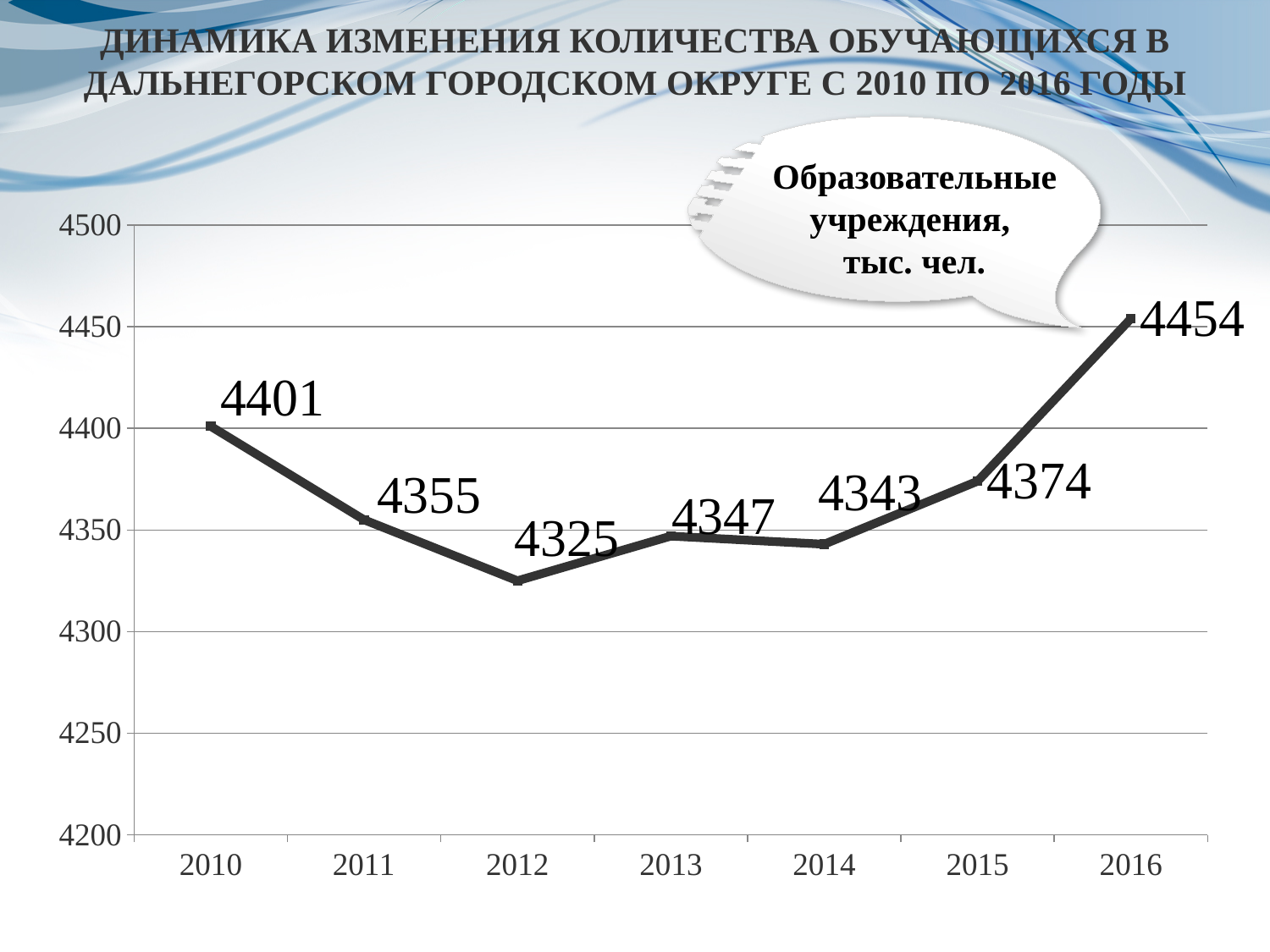
What is the value for 2016? 4454 How many years are plotted on the chart? 7 What is the difference between the values for 2016 and 2010? 53 Which is larger, the value for 2011 or the value for 2013? 2011 Which year has the lowest value? 2012 Which year has the highest value? 2016 What is the value for 2010? 4401 Do the values rise or fall from 2010 to 2012? fall What kind of chart is shown on the slide? line chart What is the value for 2014? 4343 What is the value for 2012? 4325 What is the difference between the values for 2015 and 2014? 31